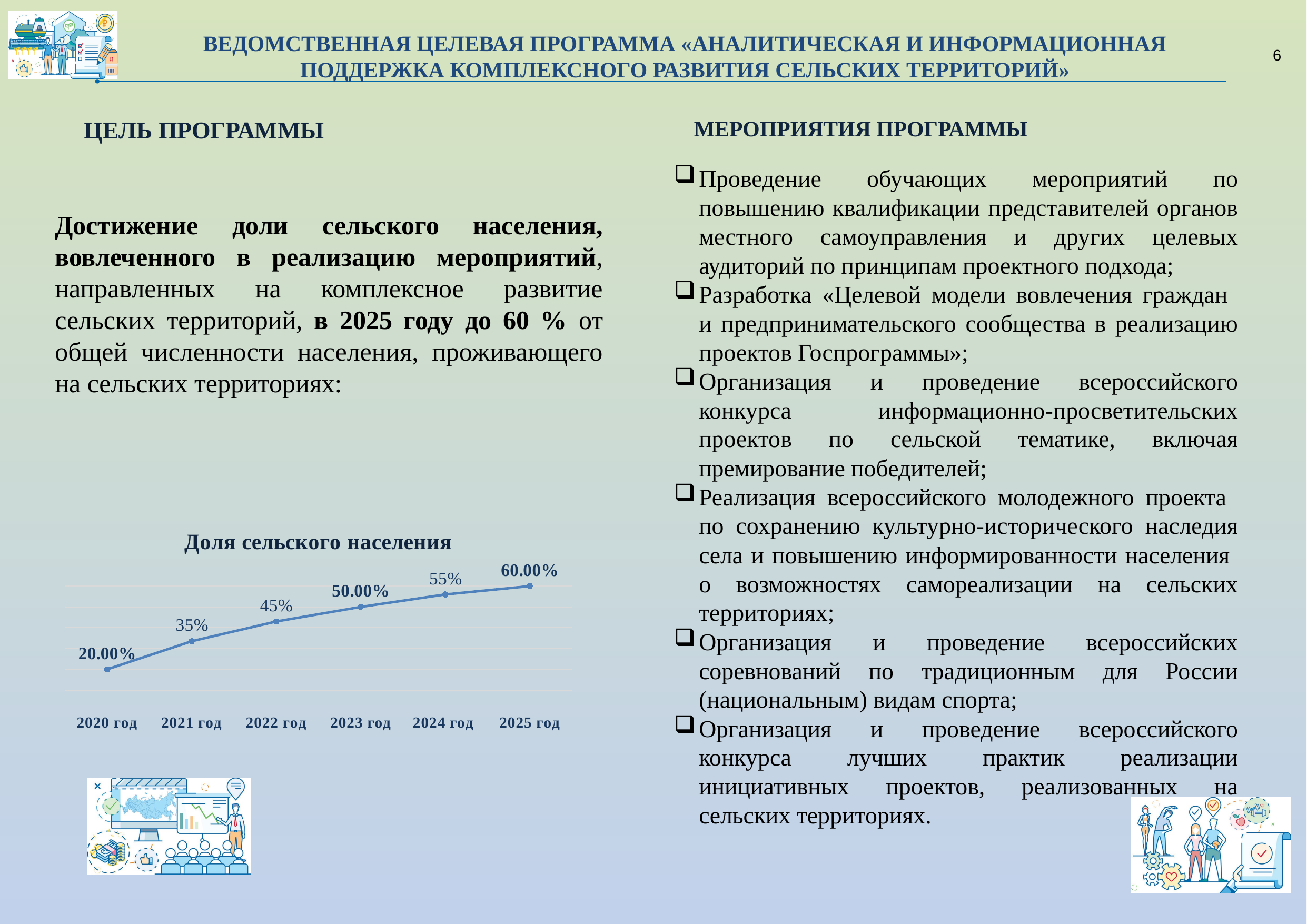
What is the difference between the values for 2025 год and 2020 год in the chart? 40 percentage points Do the values in the chart rise or fall from 2020 год to 2025 год? rise What is the title of the chart on the slide? Доля сельского населения Which year has the highest value in the chart? 2025 год What is the value for 2021 год in the chart? 35% What is the value for 2022 год in the chart? 45% How many data points are plotted in the chart? 6 What kind of chart is shown on the slide? line chart What is the value for 2025 год in the chart? 60.00% Which year has the lowest value in the chart? 2020 год What is the value for 2023 год in the chart? 50.00% What is the value for 2020 год in the chart? 20.00%